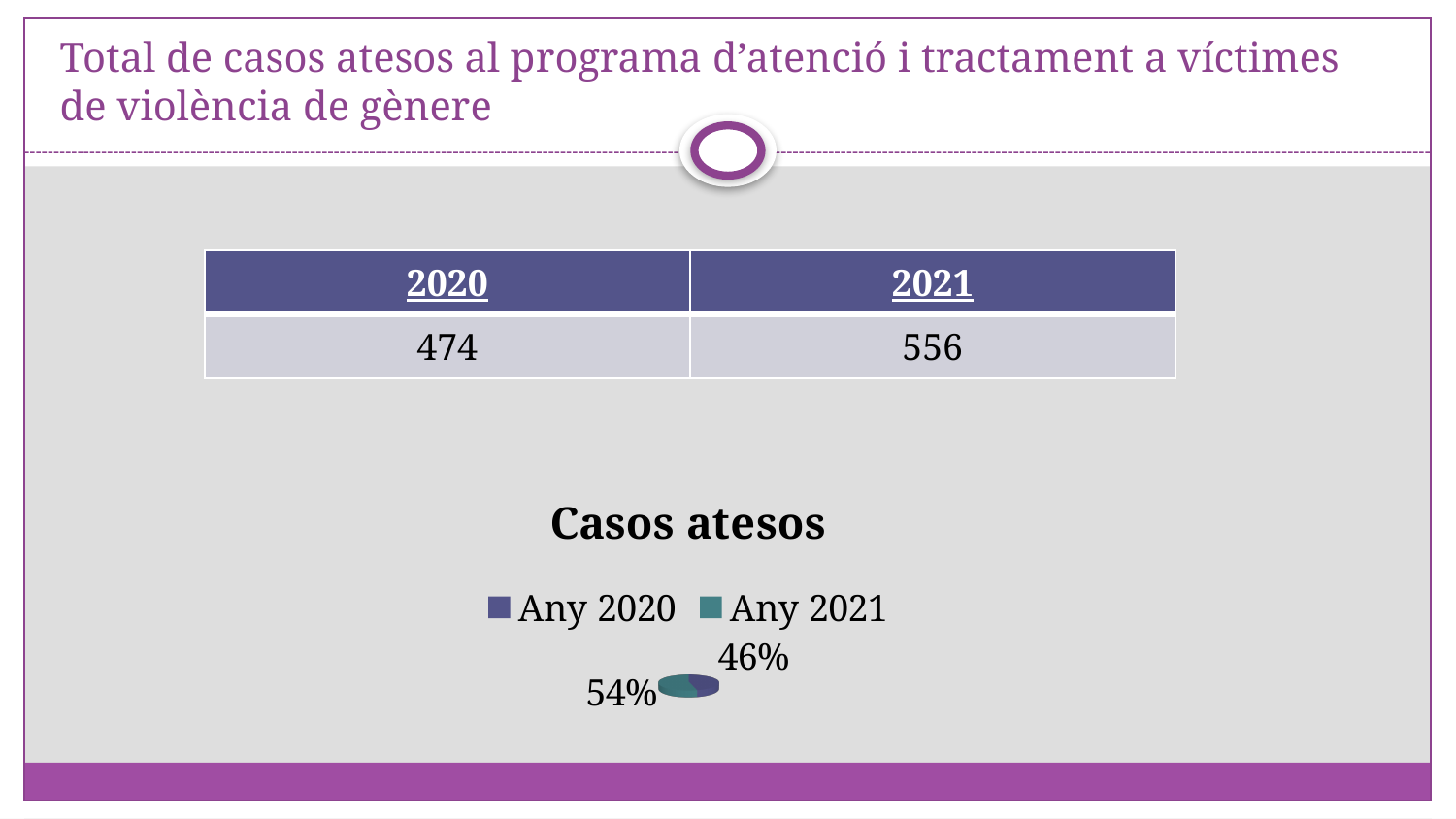
In the "Casos atesos" pie chart, which slice is larger, Any 2020 or Any 2021? Any 2021 Is the share for Any 2020 in the "Casos atesos" pie chart greater or less than 50%? less What kind of chart is shown under the title "Casos atesos"? pie chart What share of the "Casos atesos" pie does Any 2020 represent? 46% Which slice of the "Casos atesos" pie chart is the largest? Any 2021 How many slices does the "Casos atesos" pie chart have? 2 What share of the "Casos atesos" pie does Any 2021 represent? 54% What is the title of the chart on the slide? Casos atesos Which slice of the "Casos atesos" pie chart is the smallest? Any 2020 By how many percentage points does the Any 2021 share exceed the Any 2020 share in the "Casos atesos" pie chart? 8 How many entries does the legend of the "Casos atesos" chart list? 2 What are the legend entries of the "Casos atesos" pie chart? Any 2020, Any 2021